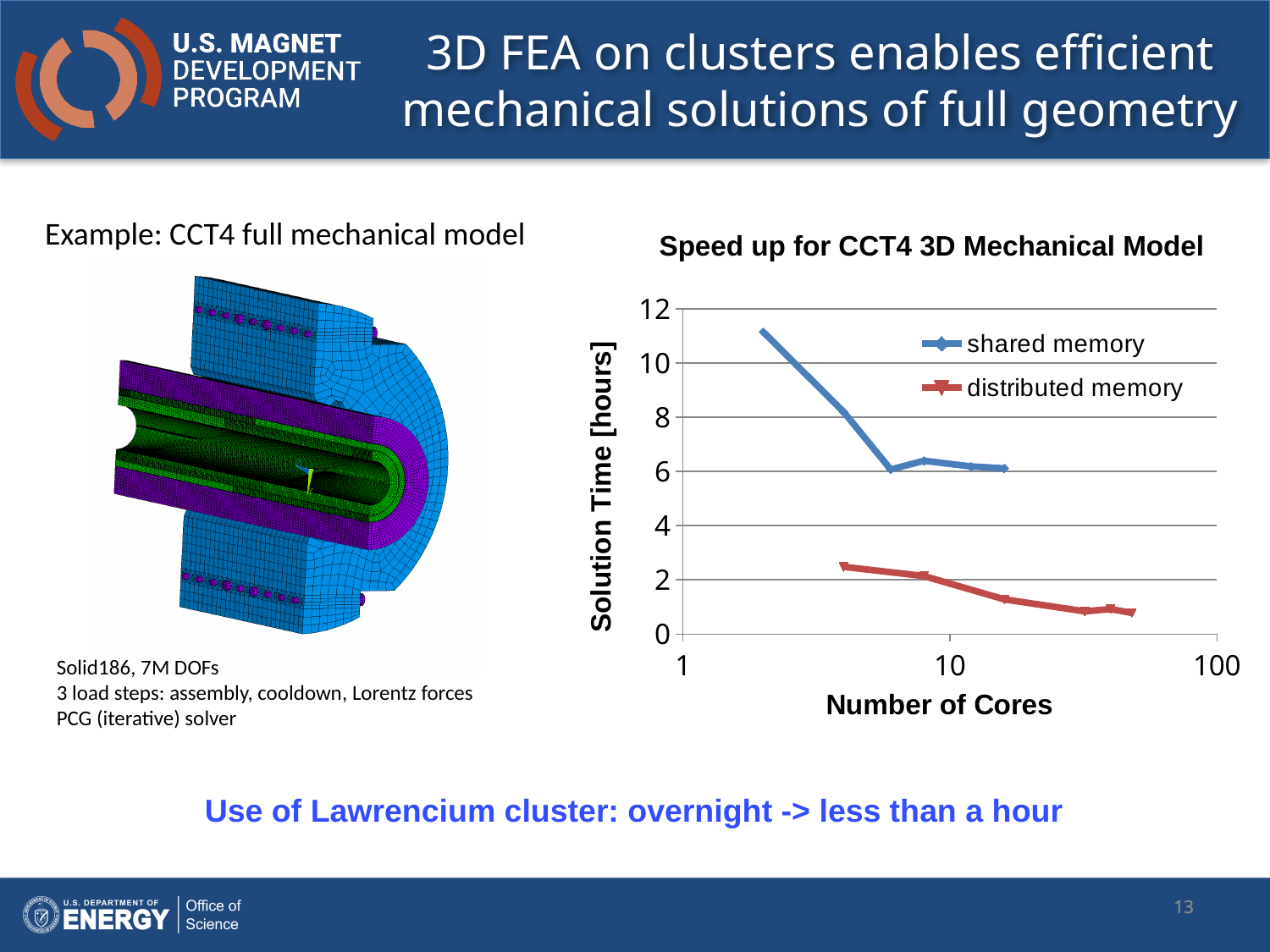
What is the title of the chart? Speed up for CCT4 3D Mechanical Model What kind of chart is shown on the slide? line chart What is the label of the y axis of the chart? Solution Time [hours] Is the lowest solution time for shared memory greater or less than 4 hours? greater Does the solution time for shared memory rise or fall as the number of cores increases? fall Does the solution time for distributed memory rise or fall as the number of cores increases? fall Is the highest solution time for shared memory greater or less than 10 hours? greater Is the highest solution time for distributed memory greater or less than 4 hours? less How many series does the chart legend list? 2 Which series has the lower solution time across the plotted core counts, shared memory or distributed memory? distributed memory Which series reaches the highest solution time on the chart? shared memory